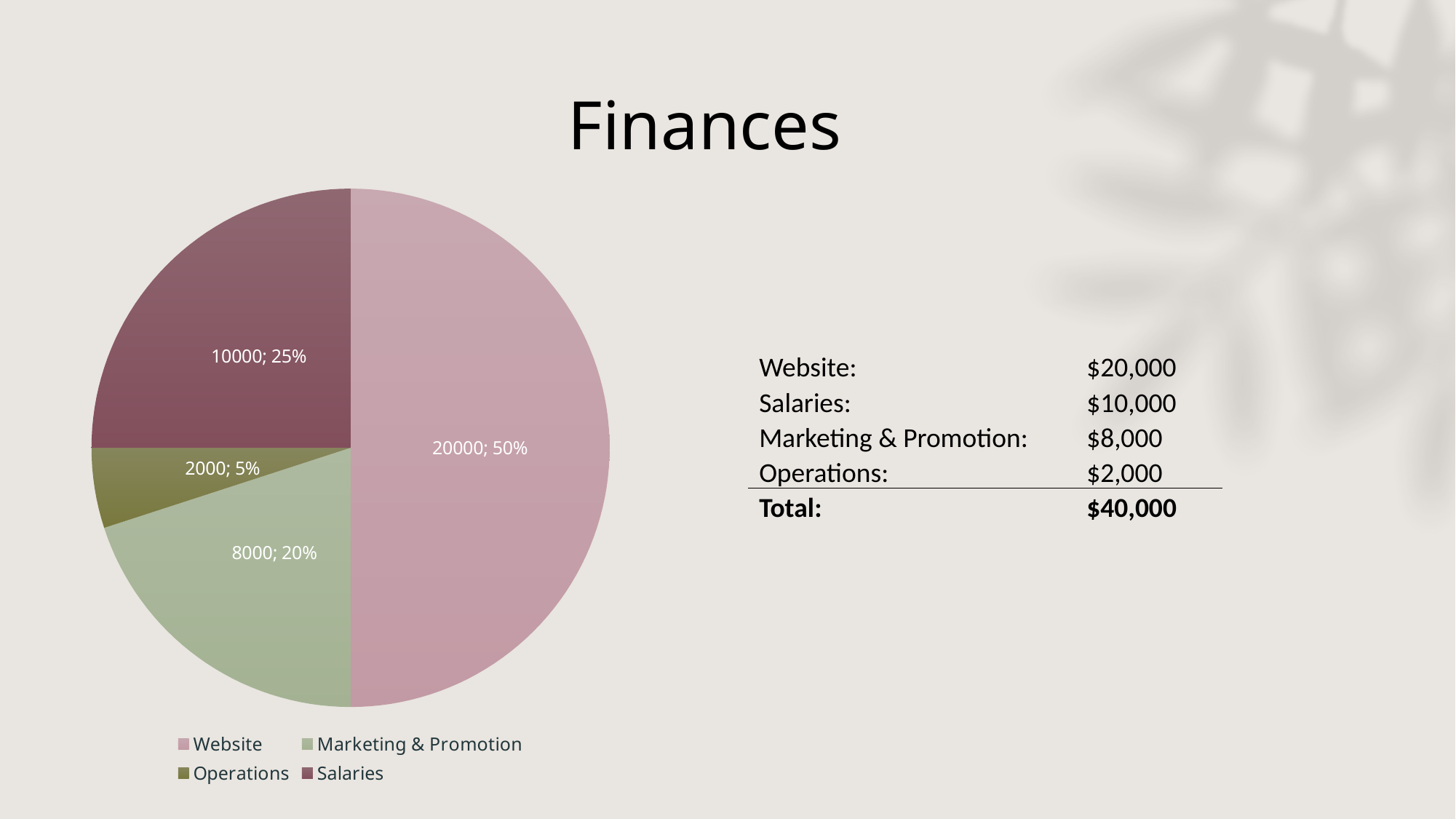
What is the difference between the Website value and the Salaries value in the pie chart? 10000 What is the title of the slide containing the pie chart? Finances How many slices does the pie chart have? 4 What value is shown for the Website slice of the pie chart? 20000 Which category has the smallest slice of the pie chart? Operations What percentage share does the Operations slice represent? 5% Which category has the largest slice of the pie chart? Website What type of chart is shown on the slide? pie chart Which is larger in the pie chart, Marketing & Promotion or Operations? Marketing & Promotion How many entries does the legend of the pie chart list? 4 What value is shown for the Marketing & Promotion slice? 8000 What percentage share does the Salaries slice represent? 25%